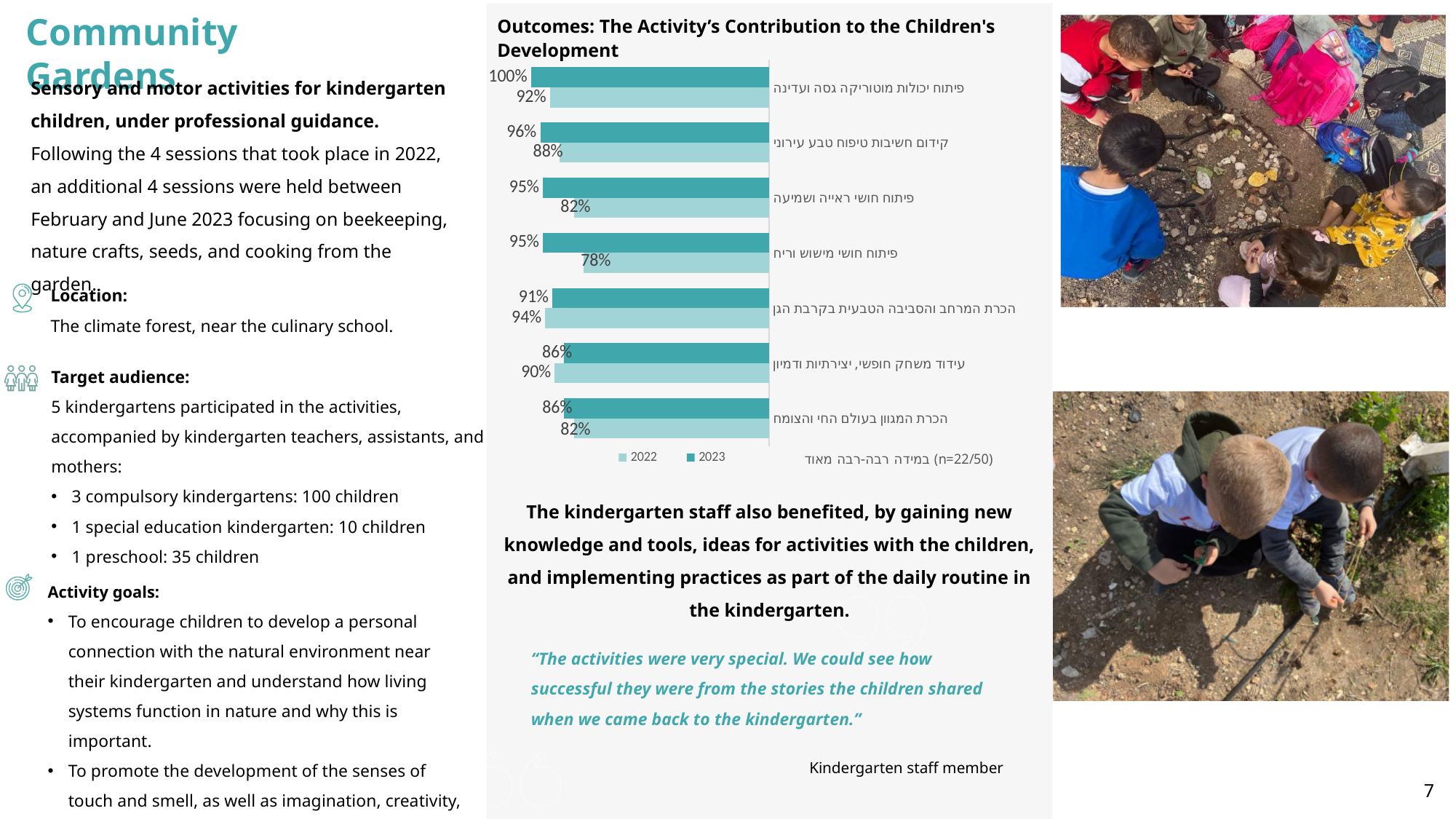
In the outcomes chart, which series is shown in the darker teal colour? 2023 How many categories are plotted in the outcomes chart? 7 What kind of chart is shown under the title "Outcomes: The Activity's Contribution to the Children's Development"? bar chart In the outcomes chart, which category has the highest 2023 value? פיתוח יכולות מוטוריקה גסה ועדינה In the outcomes chart, what is the 2022 value for the top category (פיתוח יכולות מוטוריקה גסה ועדינה)? 92% How many series does the legend of the outcomes chart list? 2 In the outcomes chart, which category has the lowest 2022 value? פיתוח חושי מישוש וריח In the outcomes chart, what is the 2023 value for the top category (פיתוח יכולות מוטוריקה גסה ועדינה)? 100% In the outcomes chart, for הכרת המרחב והסביבה הטבעית בקרבת הגן, which year has the larger value, 2022 or 2023? 2022 In the outcomes chart, what is the 2023 value for קידום חשיבות טיפוח טבע עירוני? 96% In the outcomes chart, what is the difference between the 2023 and 2022 values for פיתוח חושי ראייה ושמיעה? 13% In the outcomes chart, what is the 2022 value for פיתוח חושי מישוש וריח? 78%